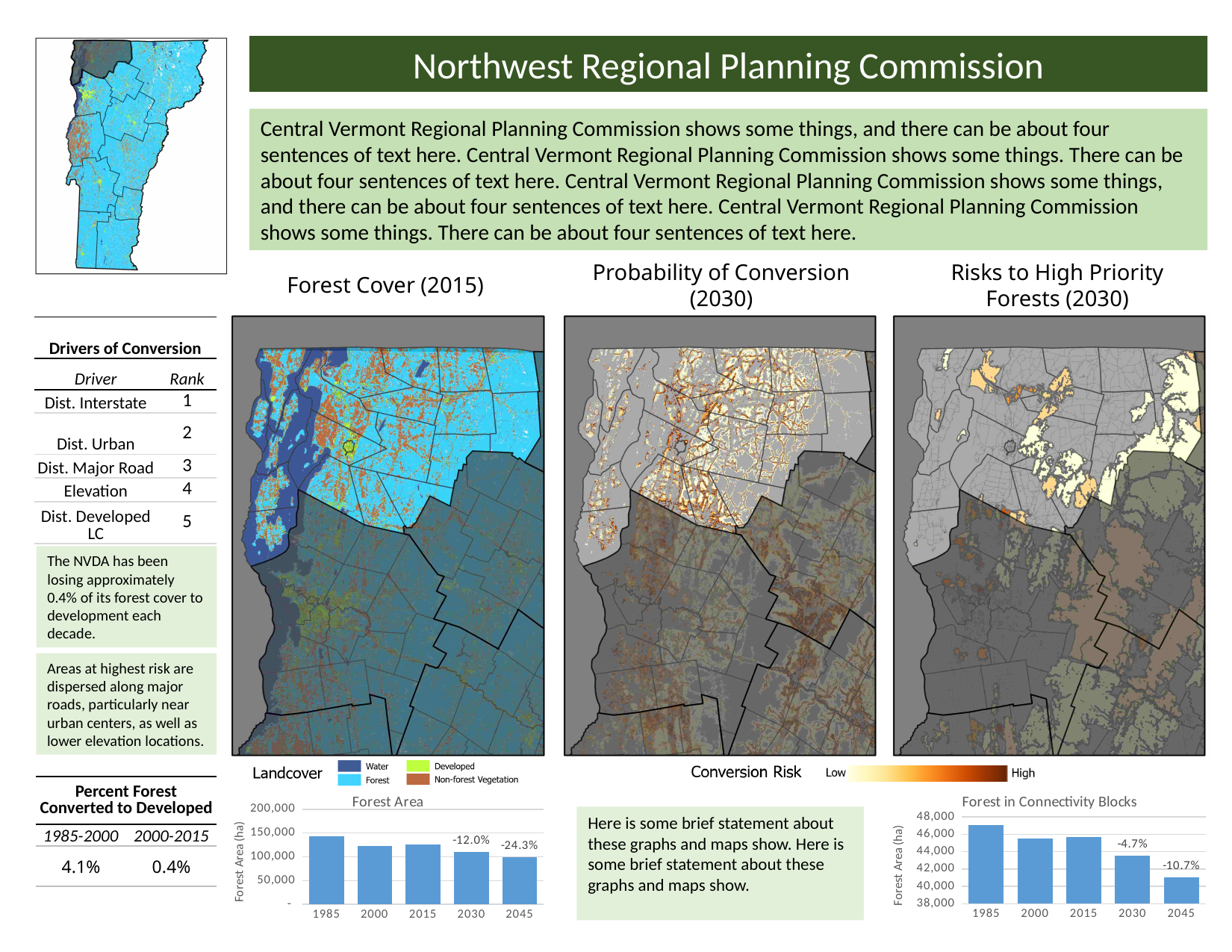
In the "Forest in Connectivity Blocks" chart, do the values generally rise or fall from 1985 to 2045? fall In the "Forest in Connectivity Blocks" chart, which year has the lowest value? 2045 In the "Forest Area" chart, is the value for 1985 greater or less than 100,000? greater What kind of chart is the "Forest Area" chart at the bottom left of the slide? bar chart In the "Forest Area" chart, which year has the lowest forest area? 2045 In the "Forest Area" chart, which year has the highest forest area? 1985 In the "Forest Area" chart, what label is printed above the 2030 bar? -12.0% In the "Forest in Connectivity Blocks" chart, which year has the highest value? 1985 In the "Forest Area" chart, is the value for 2045 greater or less than 150,000? less In the "Forest Area" chart, what label is printed above the 2045 bar? -24.3% In the "Forest in Connectivity Blocks" chart, what label is printed above the 2045 bar? -10.7% How many years are shown on the x axis of the "Forest Area" chart? 5